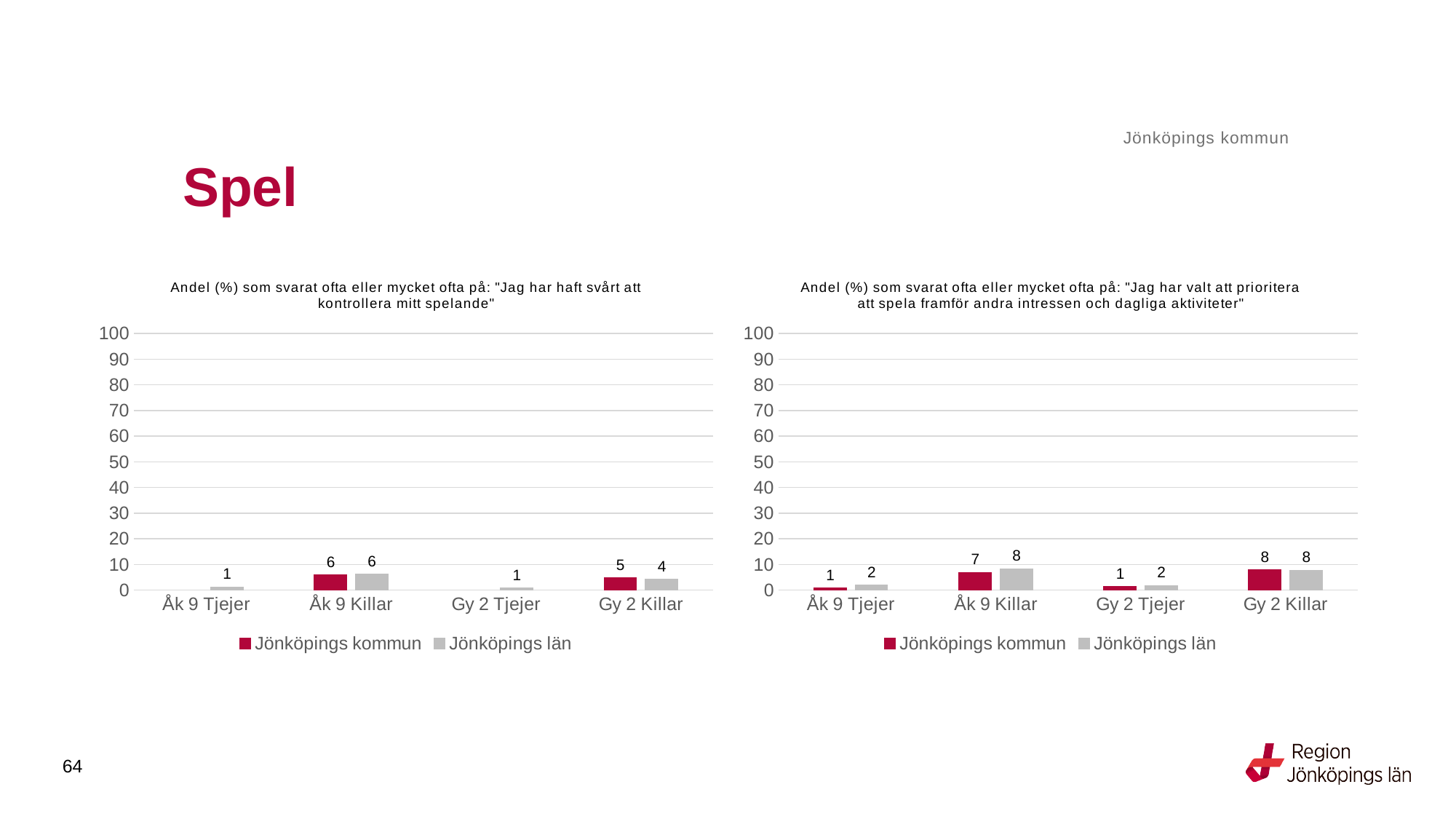
In the right chart ("Jag har valt att prioritera att spela..."), what is the value for Jönköpings kommun for Gy 2 Tjejer? 1 In the left chart ("Jag har haft svårt att kontrollera mitt spelande"), what is the difference between Jönköpings kommun and Jönköpings län for Gy 2 Killar? 1 In the right chart ("Jag har valt att prioritera att spela..."), what is the value for Jönköpings län for Åk 9 Killar? 8 In the left chart ("Jag har haft svårt att kontrollera mitt spelande"), what is the value for Jönköpings län for Gy 2 Killar? 4 In the left chart ("Jag har haft svårt att kontrollera mitt spelande"), what is the value for Jönköpings kommun for Åk 9 Killar? 6 How many series does the legend of the right chart list? 2 In the right chart ("Jag har valt att prioritera att spela..."), is the value for Jönköpings kommun for Åk 9 Killar larger or smaller than the value for Jönköpings län for Åk 9 Killar? smaller In the right chart ("Jag har valt att prioritera att spela..."), which category has the highest value for Jönköpings kommun? Gy 2 Killar In the right chart, which series is shown in grey? Jönköpings län What kind of chart is the left chart? bar chart In the right chart ("Jag har valt att prioritera att spela..."), is the value for Jönköpings län for Gy 2 Killar greater or less than 20? less How many categories are shown on the x axis of the left chart? 4